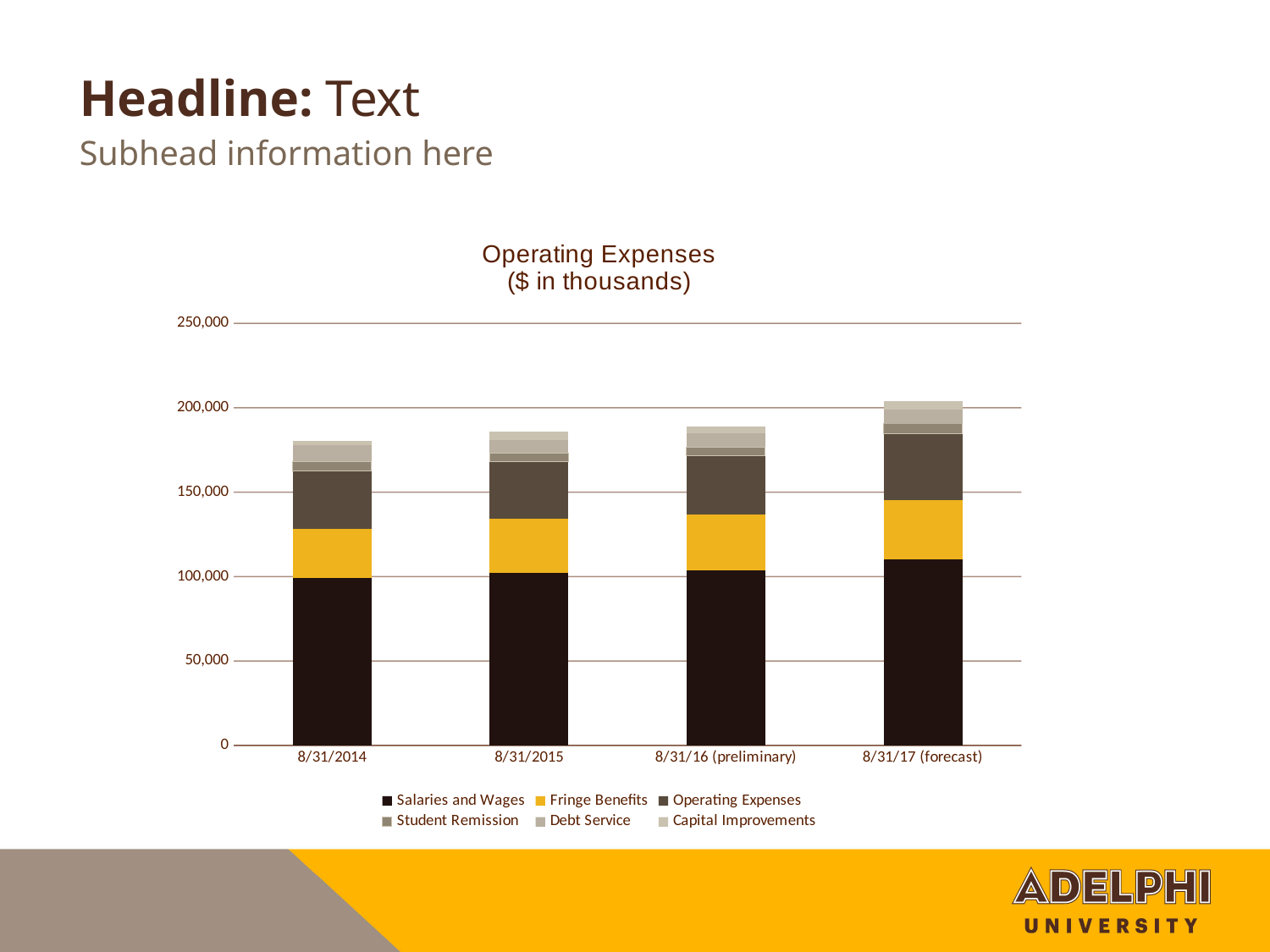
Which is larger, the Salaries and Wages value for 8/31/2014 or for 8/31/17 (forecast)? 8/31/17 (forecast) Do total operating expenses rise or fall from 8/31/2014 to 8/31/17 (forecast)? Rise Is the total for 8/31/2014 greater or less than 200,000? less Is the Salaries and Wages value for 8/31/17 (forecast) greater or less than 100,000? greater Is the total for 8/31/17 (forecast) greater or less than 200,000? greater How many series does the legend list? 6 What is the title of the chart? Operating Expenses ($ in thousands) Which series is shown in yellow in the legend? Fringe Benefits Which period has the highest total operating expenses? 8/31/17 (forecast) How many bars (periods) are shown on the x axis? 4 What kind of chart is shown on the slide? Stacked bar chart Which period has the lowest total operating expenses? 8/31/2014